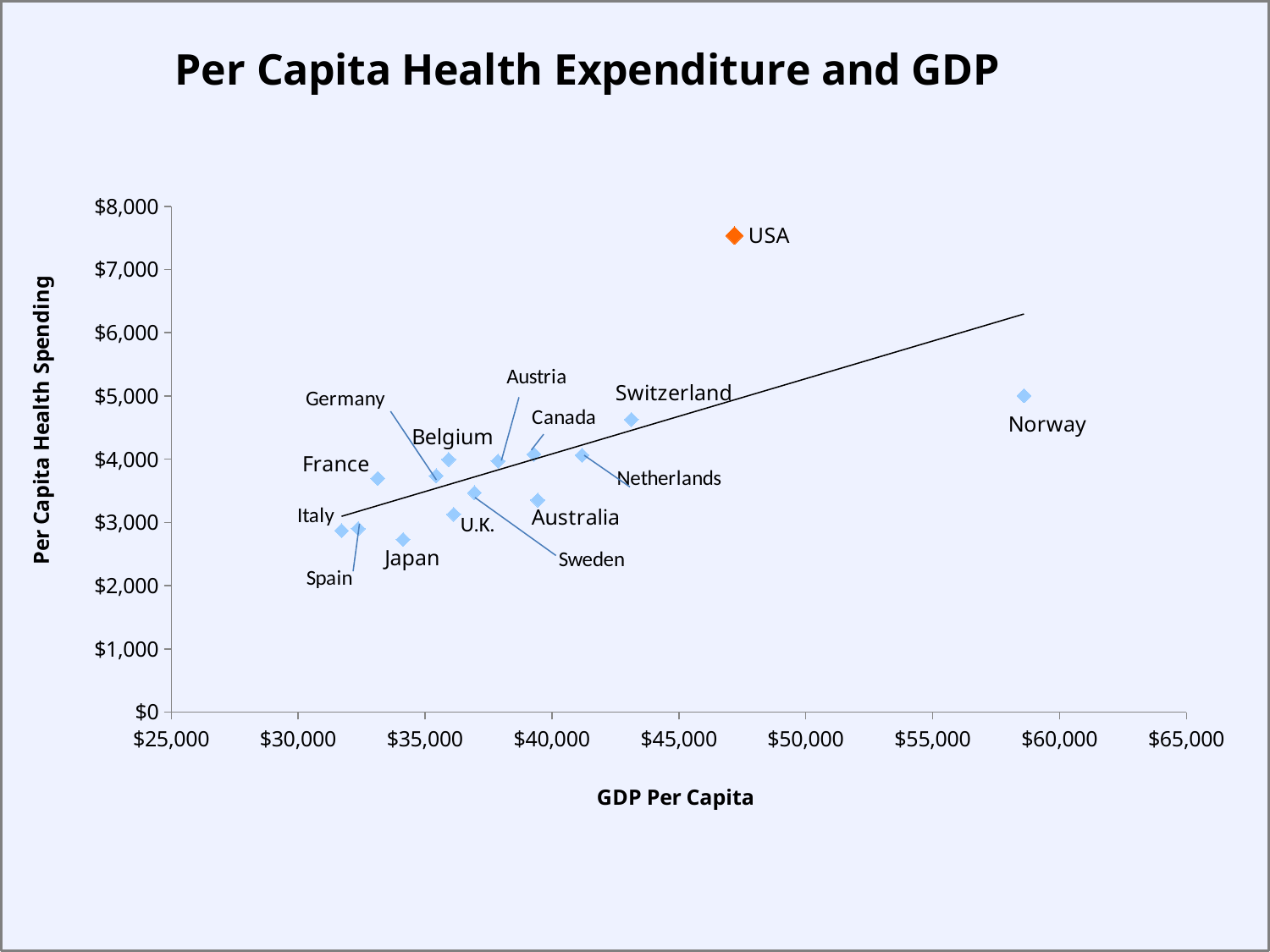
Which country has the highest GDP per capita? Norway Which has higher per capita health spending, the USA or Norway? USA Does the trend line show per capita health spending rising or falling as GDP per capita increases? rising How many countries are plotted on the chart? 15 Is the GDP per capita for Norway greater or less than $55,000? greater Is the per capita health spending for the USA greater or less than $7,000? greater Which has higher GDP per capita, Norway or Switzerland? Norway Is the GDP per capita for Italy greater or less than $35,000? less What kind of chart is shown on the slide? scatter chart Which country has the highest per capita health spending? USA